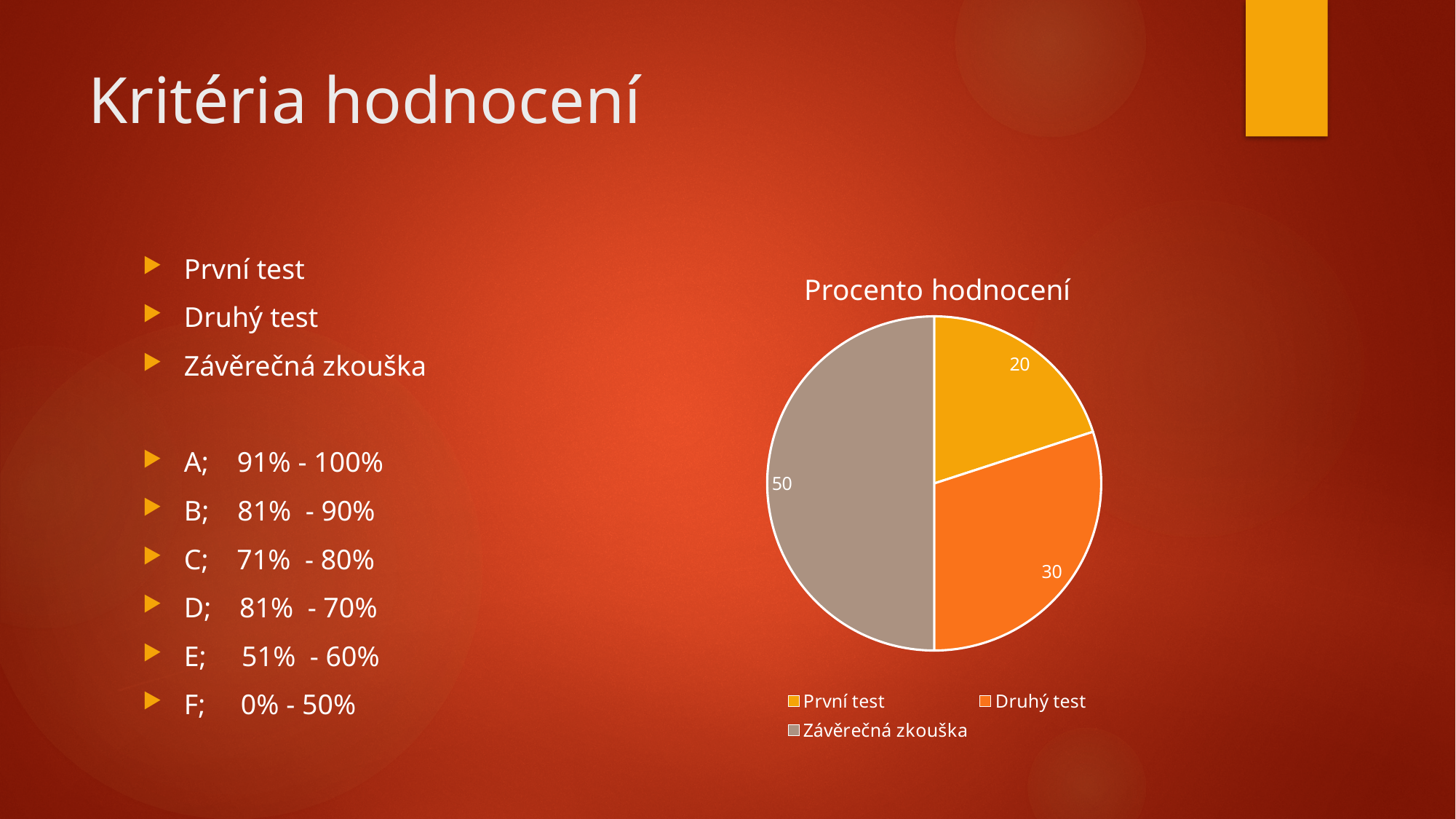
Which is larger, the value for Druhý test or the value for První test? Druhý test What is the title of the chart? Procento hodnocení Which category has the smallest slice in the pie chart? První test What is the difference between the values for Druhý test and První test? 10 Which category has the largest slice in the pie chart? Závěrečná zkouška What is the value for Druhý test in the pie chart? 30 What is the value for Závěrečná zkouška in the pie chart? 50 How many slices does the pie chart have? 3 What is the value for První test in the pie chart? 20 What share of the pie does Závěrečná zkouška represent? 50% What is the difference between the values for Závěrečná zkouška and První test? 30 What kind of chart is shown on the slide? Pie chart